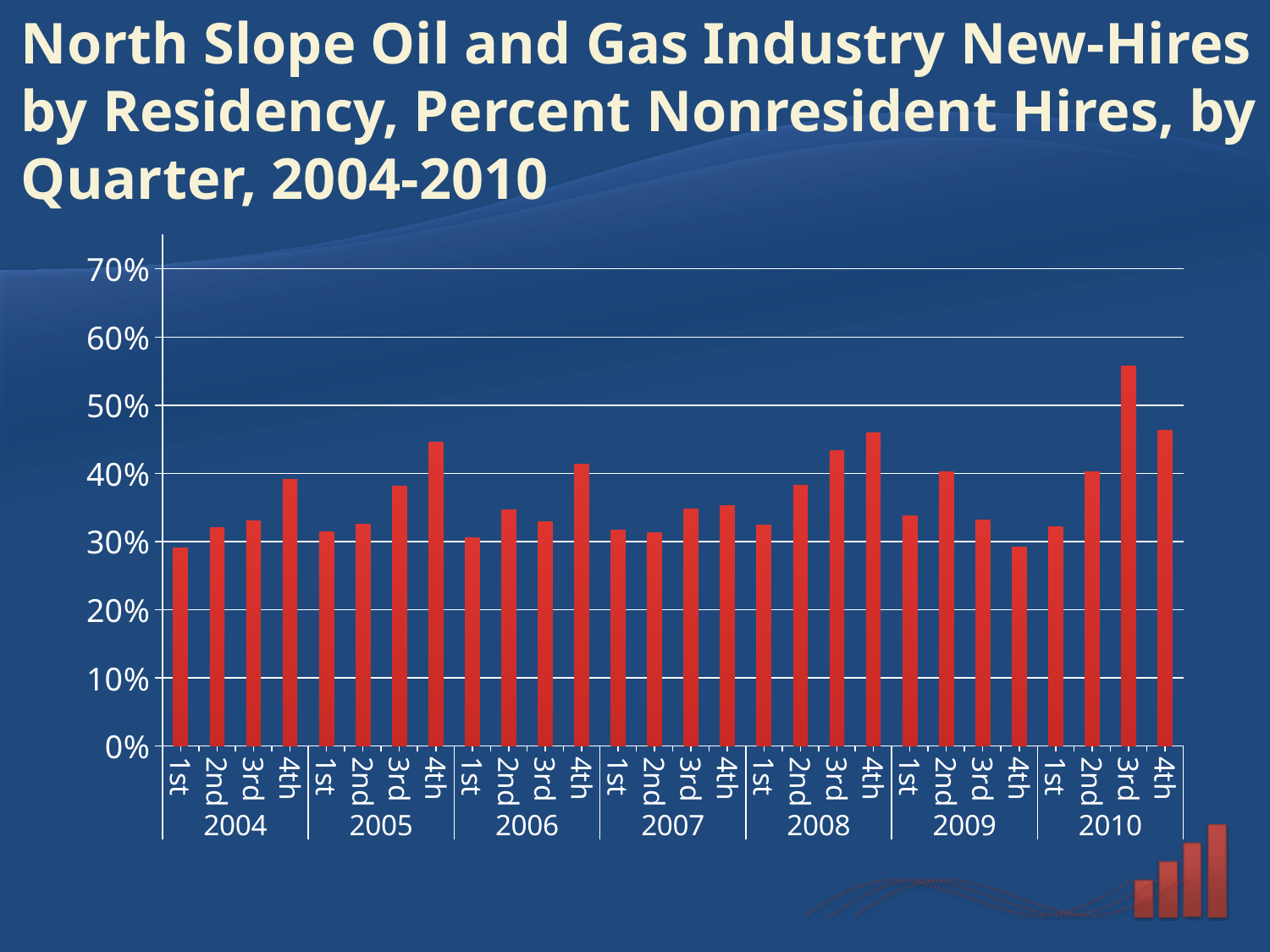
Is the value for the 4th quarter of 2005 greater or less than 40%? greater Is the value for the 1st quarter of 2004 greater or less than 30%? less How many years are shown along the x axis of the chart? 7 Is the value for the 3rd quarter of 2010 greater or less than 50%? greater How many quarterly bars are plotted in the chart? 28 Which quarter has the highest percent of nonresident hires in the chart? 3rd quarter 2010 Which is larger, the value for the 1st quarter of 2005 or the 4th quarter of 2005? 4th quarter 2005 Do the values rise or fall from the 1st quarter to the 4th quarter of 2008? rise Which is larger, the value for the 4th quarter of 2008 or the 4th quarter of 2007? 4th quarter 2008 What kind of chart is shown on the slide? Bar chart What is the title of the chart on the slide? North Slope Oil and Gas Industry New-Hires by Residency, Percent Nonresident Hires, by Quarter, 2004-2010